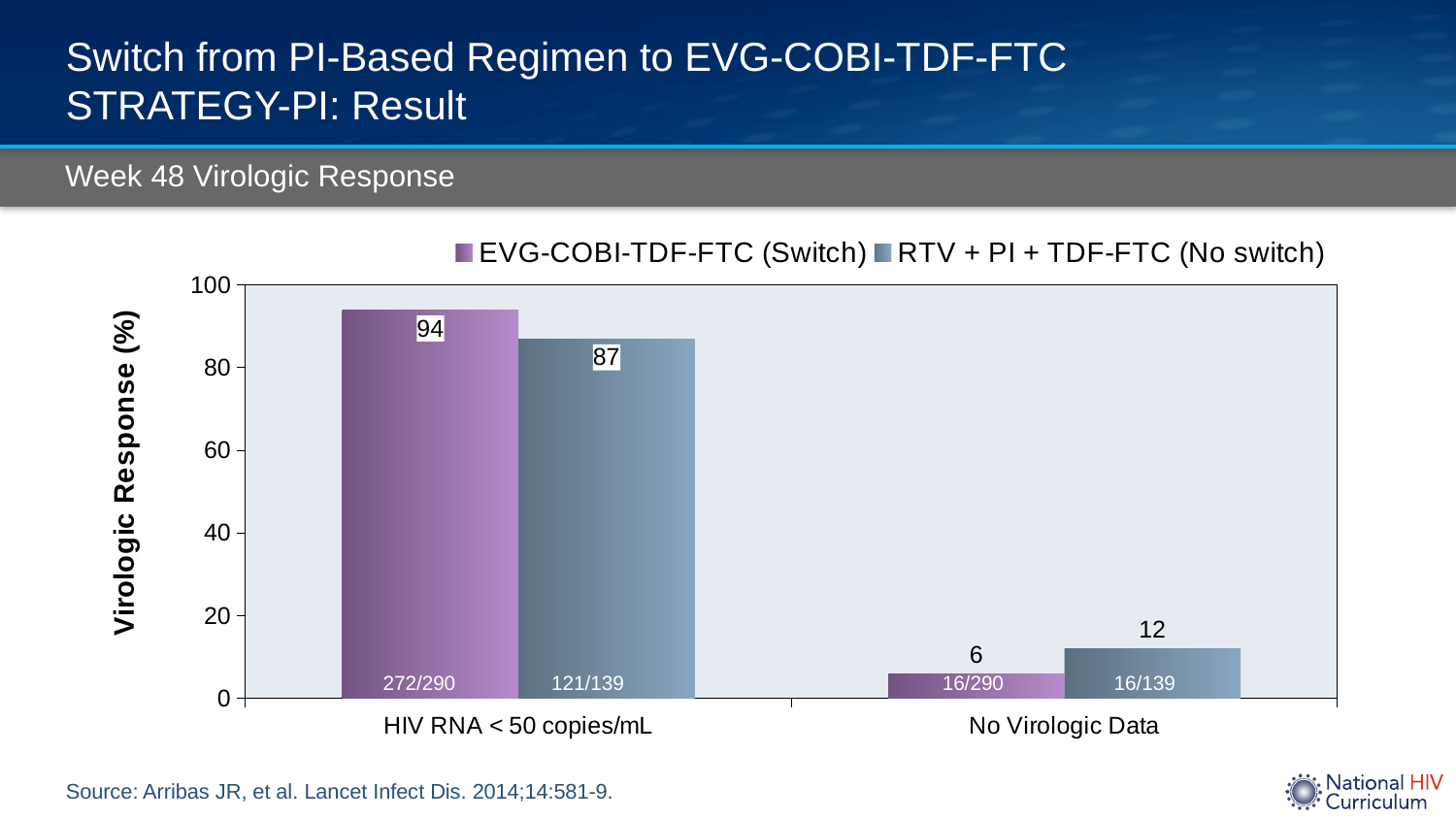
What is the value for EVG-COBI-TDF-FTC (Switch) in the No Virologic Data category? 6 Which series has the larger value in the HIV RNA < 50 copies/mL category? EVG-COBI-TDF-FTC (Switch) What is the virologic response (%) for EVG-COBI-TDF-FTC (Switch) in the HIV RNA < 50 copies/mL category? 94 How many categories are shown on the x axis? 2 Which series has the larger value in the No Virologic Data category? RTV + PI + TDF-FTC (No switch) What fraction is printed inside the Switch bar in the HIV RNA < 50 copies/mL category? 272/290 What is the value for RTV + PI + TDF-FTC (No switch) in the No Virologic Data category? 12 How many series does the legend list? 2 What is the virologic response (%) for RTV + PI + TDF-FTC (No switch) in the HIV RNA < 50 copies/mL category? 87 What kind of chart is shown on the slide? Bar chart What is the difference between the No switch and Switch values in the No Virologic Data category? 6 What is the difference between the Switch and No switch values in the HIV RNA < 50 copies/mL category? 7